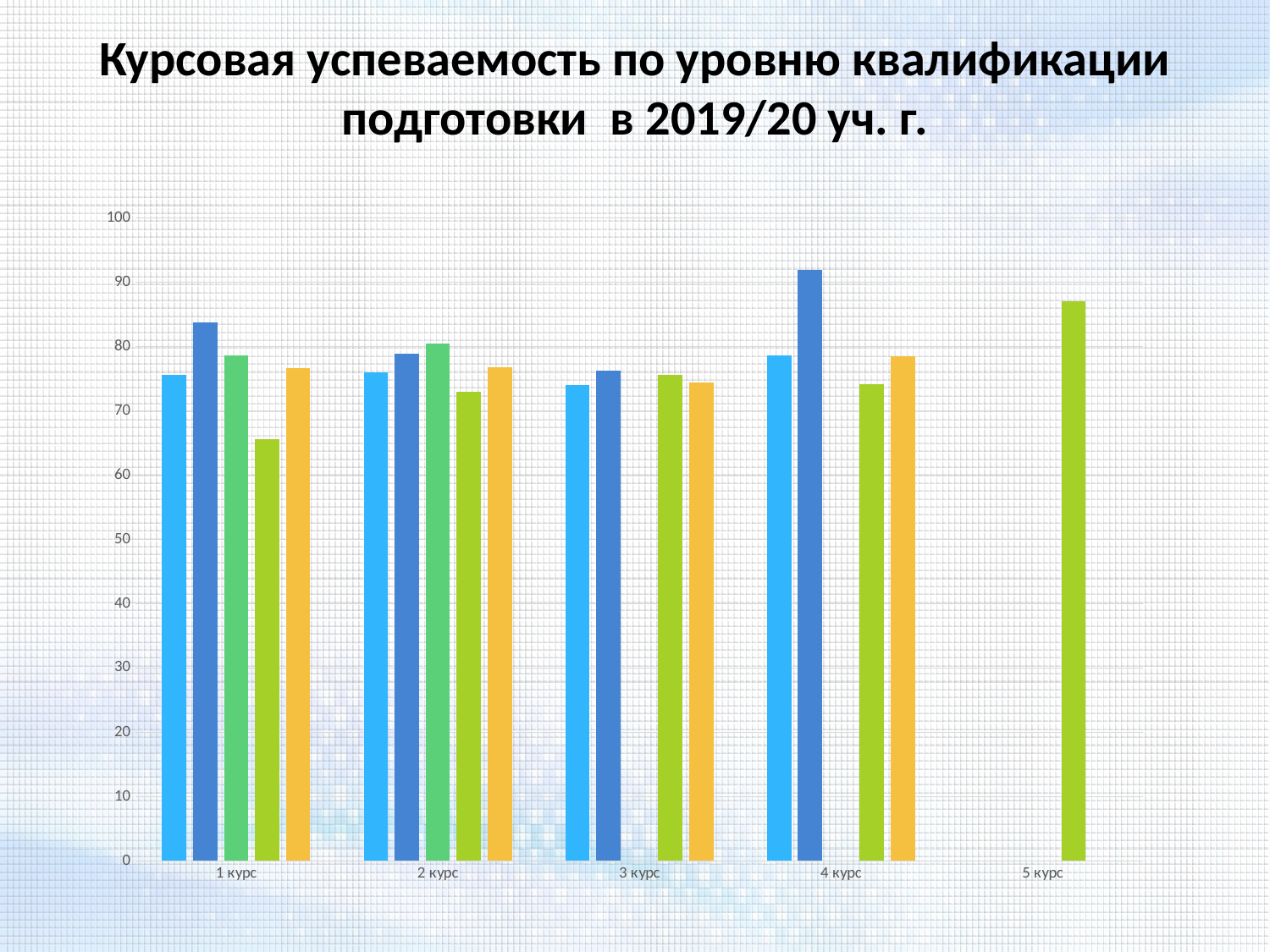
Is the value of the only bar for 5 курс greater or less than 80? greater What is the highest value shown on the vertical axis? 100 Which category contains the tallest bar in the chart? 4 курс Is the value of the shortest bar for 1 курс greater or less than 70? less Is the value of the shortest bar for 3 курс greater or less than 70? greater What is the title of the slide's chart? Курсовая успеваемость по уровню квалификации подготовки в 2019/20 уч. г. What kind of chart is shown on the slide? bar chart How many categories are shown on the x axis of the chart? 5 How many bars are plotted for 5 курс? 1 How many bars are plotted for 1 курс? 5 Which is taller: the tallest bar for 4 курс or the bar for 5 курс? the tallest bar for 4 курс